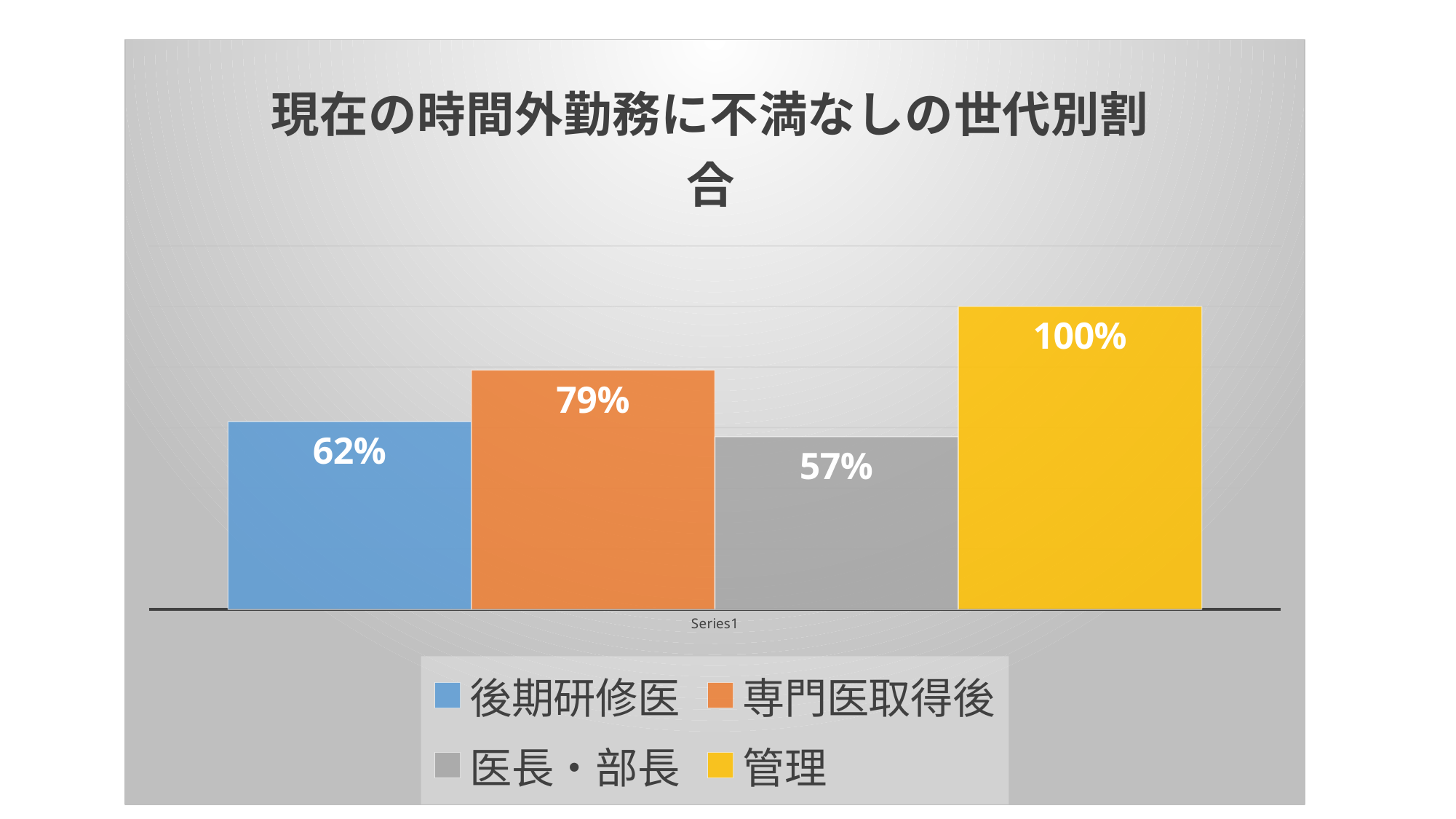
What kind of chart is shown on the slide? Bar chart What is the difference between the values for 管理 and 医長・部長? 43% What is the value for 後期研修医? 62% What is the value for 管理? 100% What is the value for 医長・部長? 57% Which is larger, the value for 後期研修医 or the value for 医長・部長? 後期研修医 Which group has the lowest value? 医長・部長 What is the difference between the values for 専門医取得後 and 後期研修医? 17% How many series does the legend list? 4 What is the title of the chart? 現在の時間外勤務に不満なしの世代別割合 What is the value for 専門医取得後? 79% Which group has the highest value? 管理